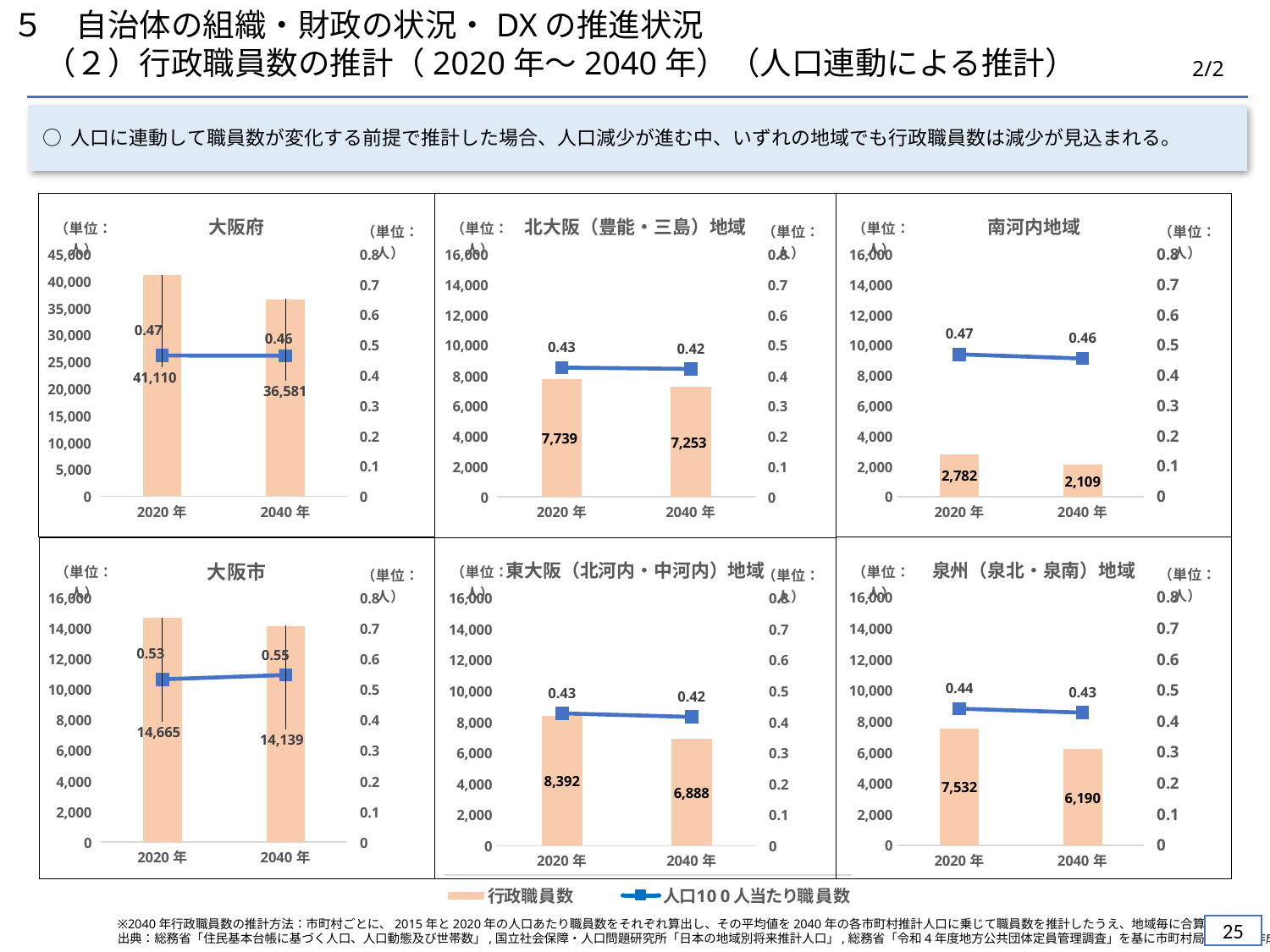
In the 大阪府 chart, what is the value of 行政職員数 for 2020年? 41,110 How many charts are shown on the slide? 6 In the 北大阪（豊能・三島）地域 chart, what is the value of 行政職員数 for 2040年? 7,253 How many series does the shared legend at the bottom of the slide list? 2 In the 大阪市 chart, which year has the higher value of 人口100人当たり職員数, 2020年 or 2040年? 2040年 In the 南河内地域 chart, is the 行政職員数 bar for 2020年 greater or less than 4,000? less In the 泉州（泉北・泉南）地域 chart, what is the value of 人口100人当たり職員数 for 2020年? 0.44 In the 東大阪（北河内・中河内）地域 chart, what is the difference in 行政職員数 between 2020年 and 2040年? 1,504 In the 南河内地域 chart, what is the difference in 行政職員数 between 2020年 and 2040年? 673 In the 大阪府 chart, what is the value of 人口100人当たり職員数 for 2040年? 0.46 In the 大阪市 chart, what is the value of 行政職員数 for 2040年? 14,139 In the 泉州（泉北・泉南）地域 chart, does 行政職員数 rise or fall from 2020年 to 2040年? fall